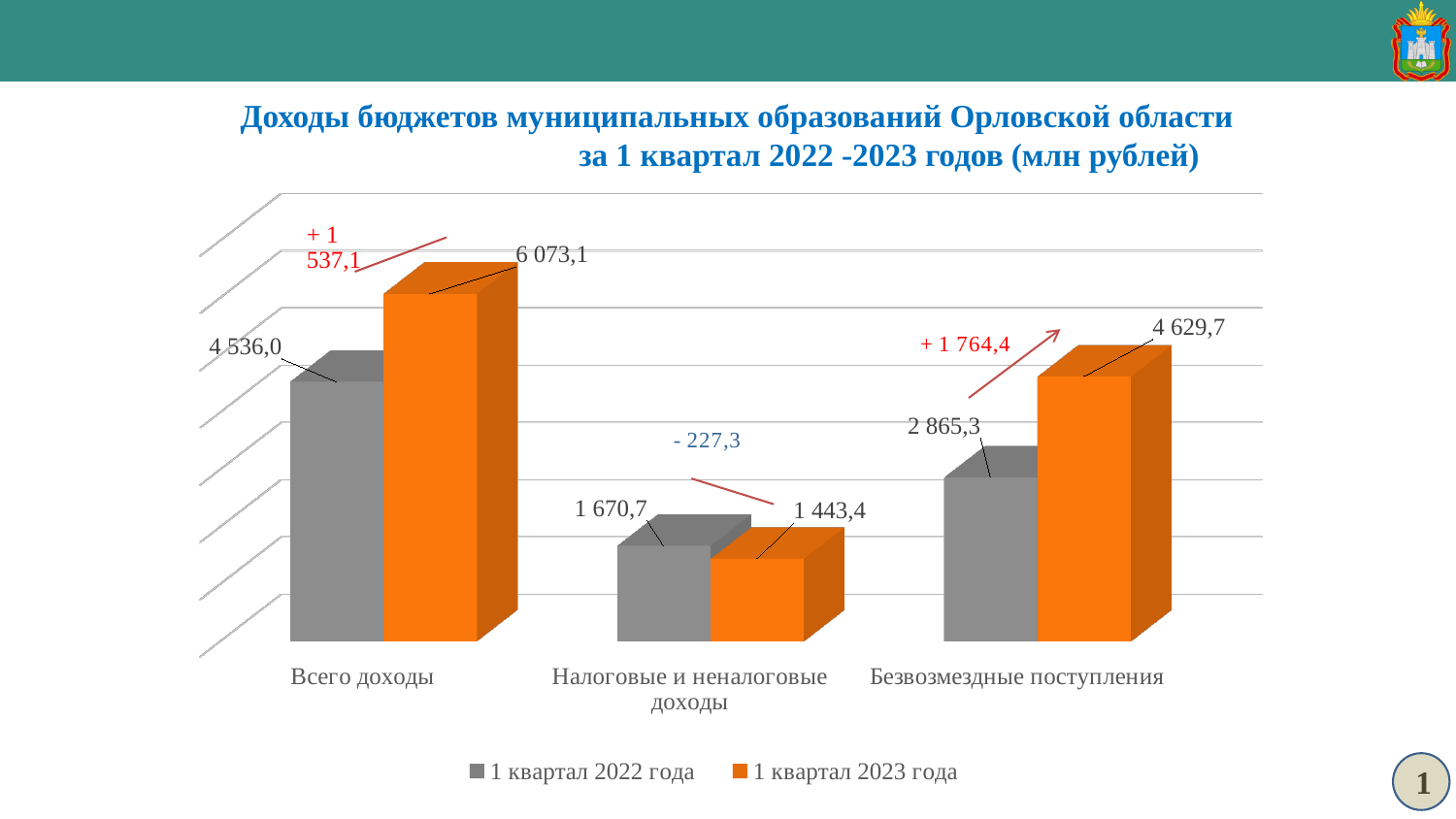
Which is larger for Налоговые и неналоговые доходы: the 1 квартал 2022 года value or the 1 квартал 2023 года value? 1 квартал 2022 года What colour are the bars for 1 квартал 2023 года? Orange What is the value for Всего доходы in 1 квартал 2023 года? 6 073,1 Which category has the highest value in 1 квартал 2022 года? Всего доходы What is the value for Всего доходы in 1 квартал 2022 года? 4 536,0 What kind of chart is shown on the slide? Bar chart How many categories are shown on the x axis? 3 What is the value for Налоговые и неналоговые доходы in 1 квартал 2023 года? 1 443,4 Which category has the lowest value in 1 квартал 2023 года? Налоговые и неналоговые доходы How many series does the legend list? 2 What is the value for Безвозмездные поступления in 1 квартал 2022 года? 2 865,3 What is the difference between the 1 квартал 2023 года and 1 квартал 2022 года values for Безвозмездные поступления? 1 764,4